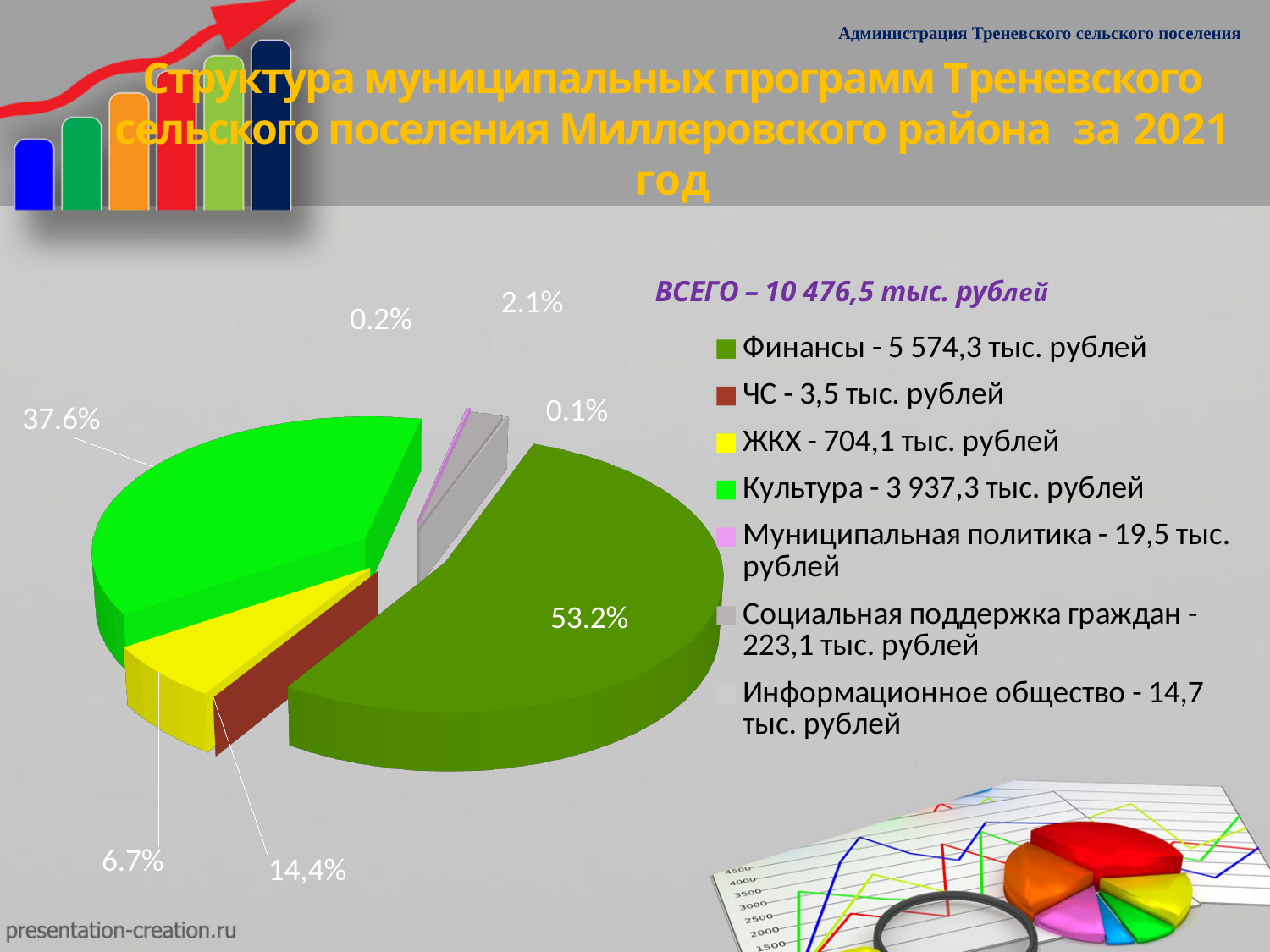
What is the value for Финансы according to the legend? 5 574,3 тыс. рублей What is the value for Культура according to the legend? 3 937,3 тыс. рублей How many categories does the legend of the pie chart list? 7 Which category has the smallest value? ЧС Which category has the largest value? Финансы What is the value for Информационное общество according to the legend? 14,7 тыс. рублей What share of the pie does Культура take? 37.6% What share of the pie does Финансы take? 53.2% What is the value for ЖКХ according to the legend? 704,1 тыс. рублей What is the difference between the values for Финансы and Культура? 1 637,0 тыс. рублей Which is larger: Социальная поддержка граждан or Муниципальная политика? Социальная поддержка граждан What kind of chart is shown on the slide? pie chart